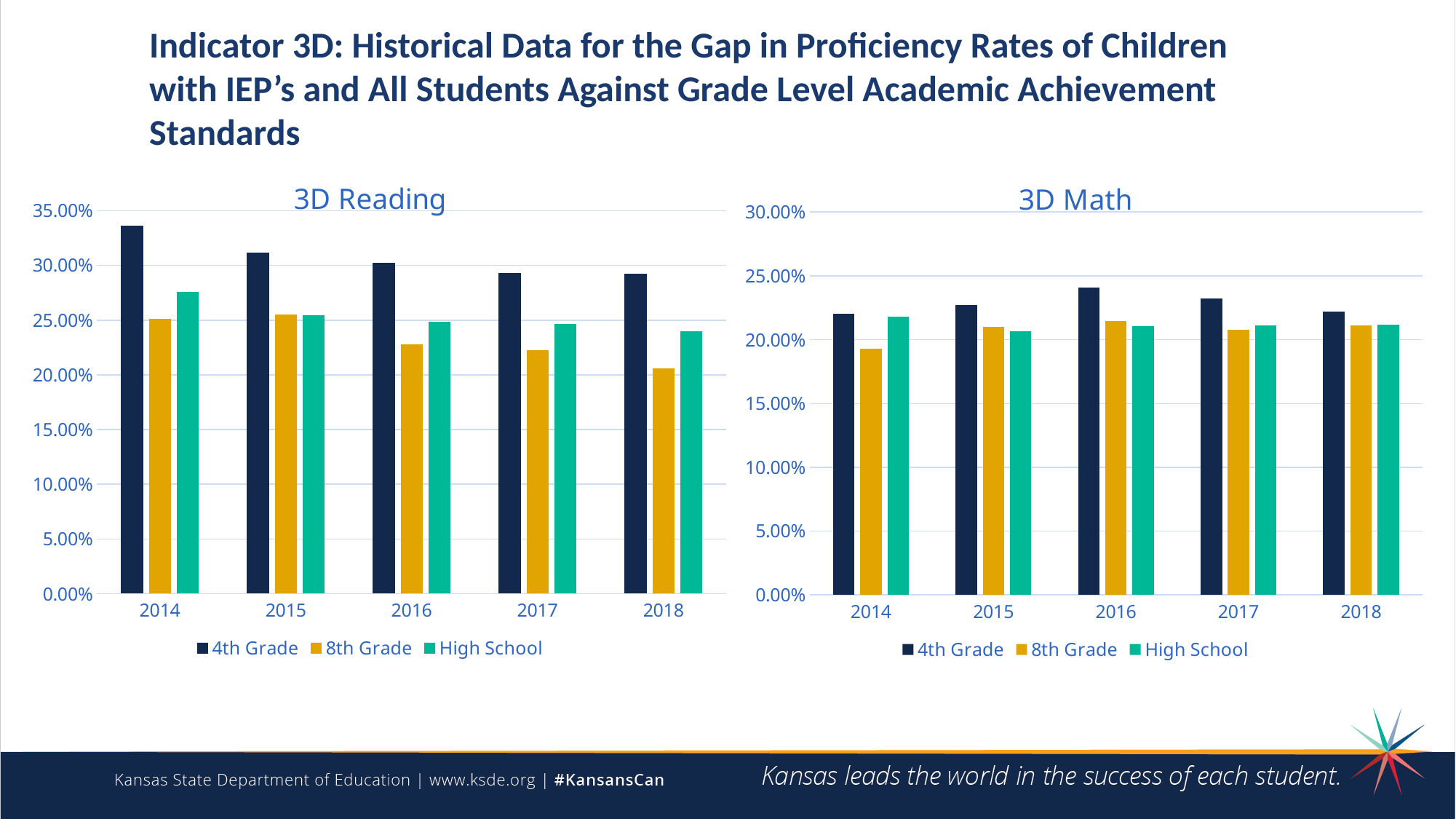
In the 3D Math chart, which is larger for 2014: the 8th Grade value or the High School value? High School How many series does the legend of the 3D Reading chart list? 3 How many years are shown on the x axis of the 3D Math chart? 5 In the 3D Math chart, which year has the highest 4th Grade value? 2016 In the 3D Reading chart, is the 8th Grade value for 2018 greater or less than 25.00%? less In the 3D Reading chart, which year has the highest 4th Grade value? 2014 In the 3D Reading chart, do the 4th Grade values rise or fall from 2014 to 2018? fall In the 3D Math chart, is the 8th Grade value for 2014 greater or less than 20.00%? less In the 3D Reading chart, which year has the lowest 8th Grade value? 2018 What kind of chart is the 3D Reading chart? bar chart What are the three legend entries in the 3D Math chart? 4th Grade, 8th Grade, High School In the 3D Reading chart, is the 4th Grade value for 2014 greater or less than 30.00%? greater